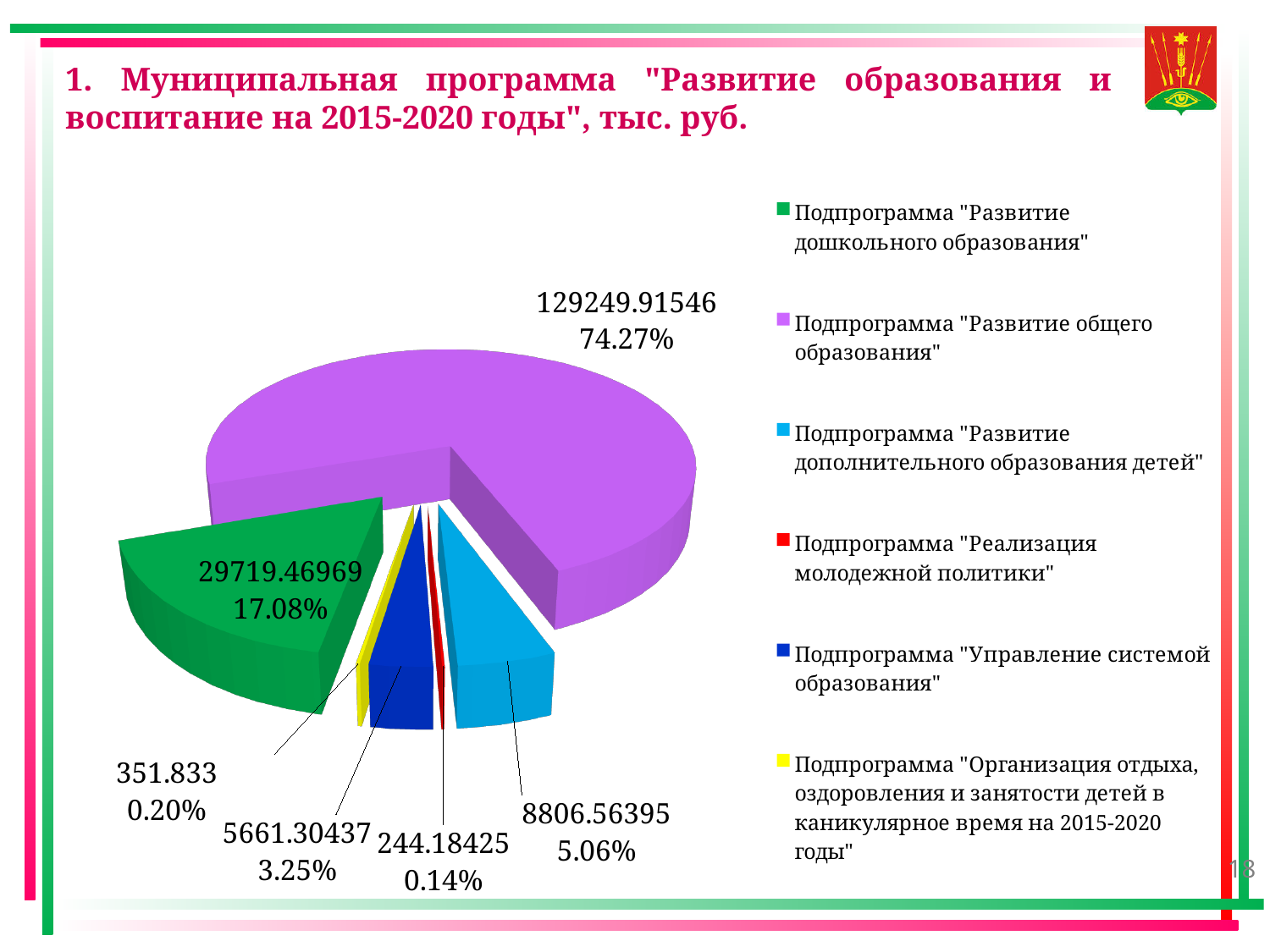
What is the value for Подпрограмма "Развитие общего образования"? 129249.91546 What share of the pie does Подпрограмма "Организация отдыха, оздоровления и занятости детей в каникулярное время на 2015-2020 годы" take? 0.20% What kind of chart is shown on the slide? pie chart What is the value for Подпрограмма "Управление системой образования"? 5661.30437 What share of the pie does Подпрограмма "Реализация молодежной политики" take? 0.14% What is the value for Подпрограмма "Развитие дополнительного образования детей"? 8806.56395 Which subprogram has the largest slice of the pie? Подпрограмма "Развитие общего образования" How many slices does the pie chart have? 6 What is the value for Подпрограмма "Развитие дошкольного образования"? 29719.46969 Which subprogram has the smallest slice of the pie? Подпрограмма "Реализация молодежной политики" Which colour represents Подпрограмма "Развитие дошкольного образования" in the chart? green How many entries does the legend list? 6